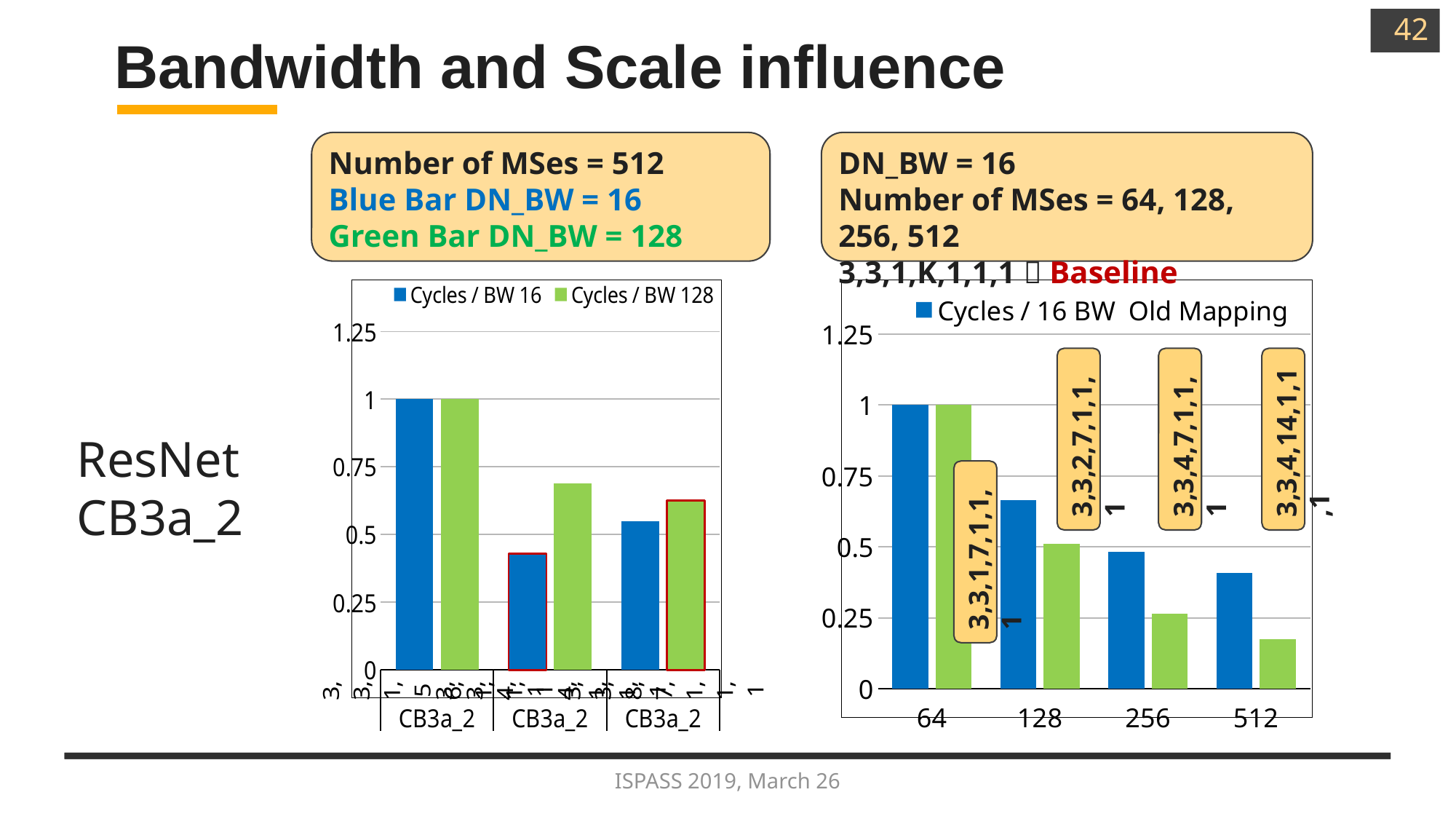
In the left chart, which series is shown in green? Cycles / BW 128 What kind of chart is the chart on the right of the slide? bar chart In the left chart, which CB3a_2 group has the lowest Cycles / BW 16 (blue) bar? the middle group In the right chart, do the blue bars rise or fall as the number of MSes increases from 64 to 512? fall In the right chart, what is the value of the blue bar for category 64? 1 How many series does the legend of the left chart list? 2 In the left chart, is the blue bar in the middle CB3a_2 group greater or less than 0.5? less In the right chart, is the blue bar for category 128 greater or less than 0.5? greater How many categories are on the x axis of the right chart? 4 In the right chart, for category 256, is the blue bar or the green bar larger? blue bar In the right chart, which category has the lowest green bar? 512 In the right chart, is the green bar for category 512 greater or less than 0.25? less